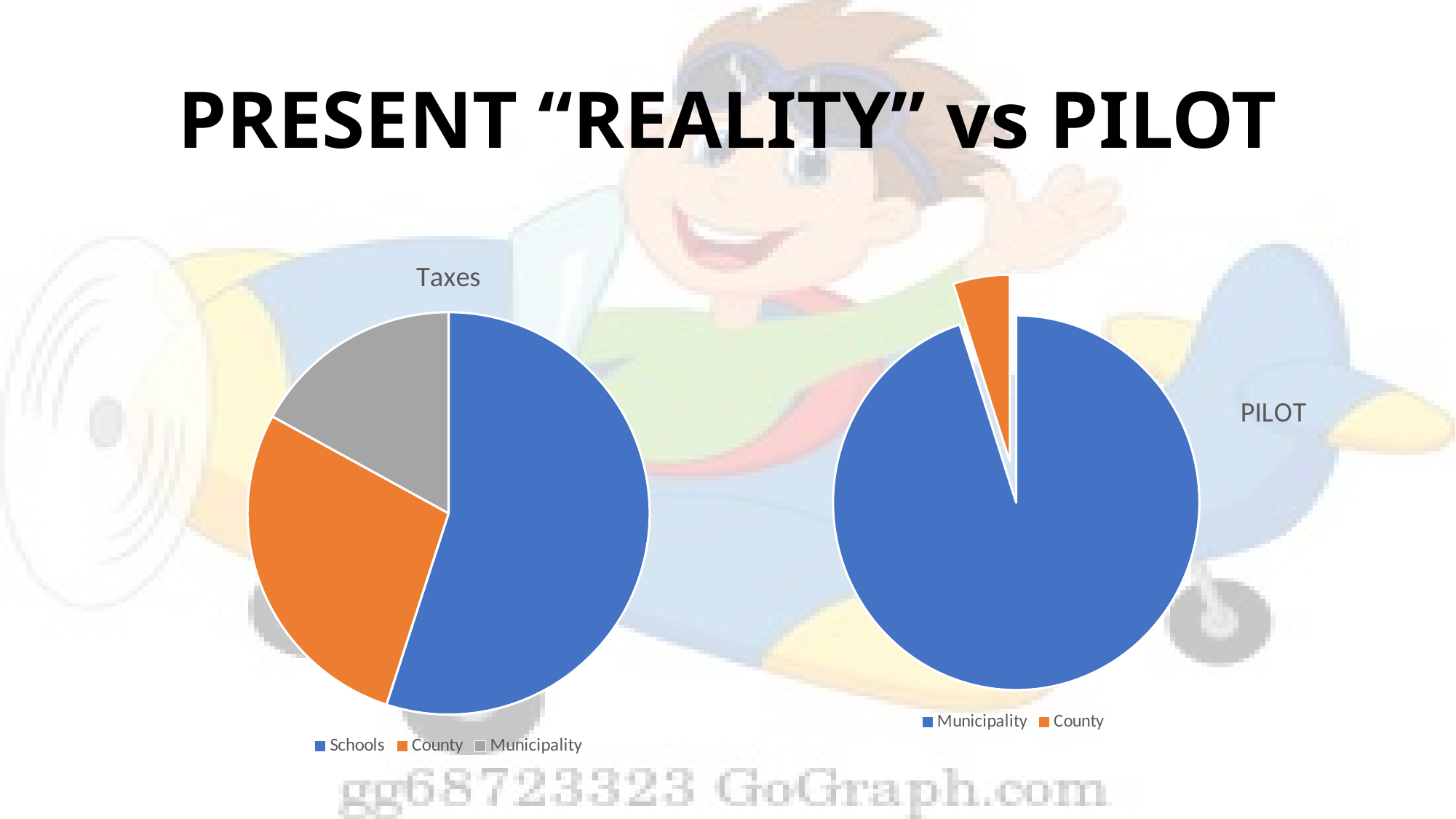
In the "Taxes" chart, which slice is larger, County or Municipality? County In the "PILOT" chart, which category has the largest slice? Municipality In the "PILOT" chart, which category has the smallest slice? County In the "Taxes" chart, what colour is the Schools slice? Blue In the "Taxes" chart, which category has the largest slice? Schools What is the title of the pie chart on the left? Taxes In the "PILOT" chart, how many categories does the legend list? 2 In the "Taxes" chart, how many categories does the legend list? 3 What kind of chart is the "PILOT" chart on the right? Pie chart In the "PILOT" chart, which slice is larger, Municipality or County? Municipality What kind of chart is the "Taxes" chart on the left? Pie chart In the "Taxes" chart, which category has the smallest slice? Municipality